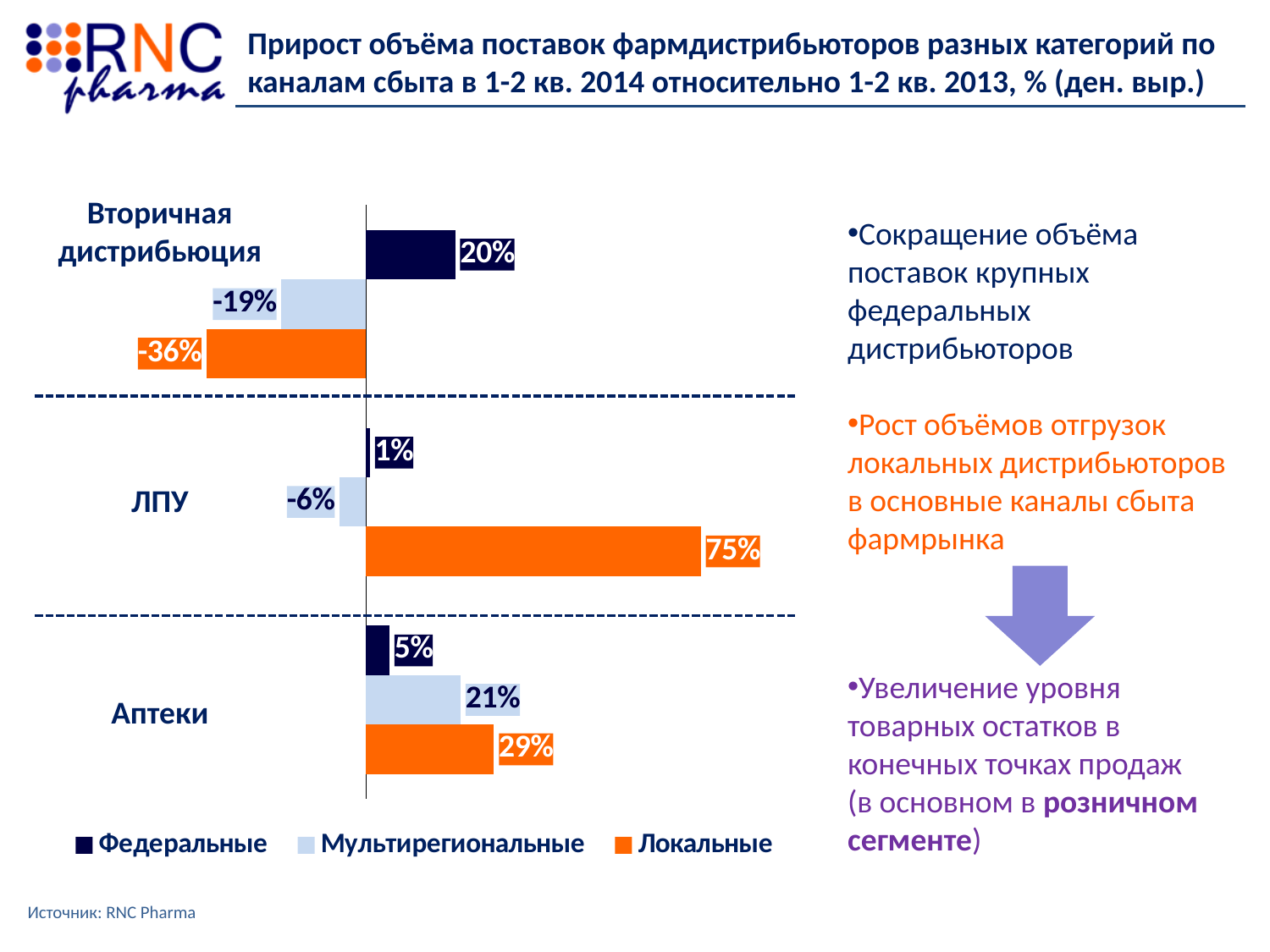
What is the value for Локальные in the ЛПУ category? 75% Which is larger in the Аптеки category: the Федеральные value or the Мультирегиональные value? Мультирегиональные Which series has the lowest value in the Вторичная дистрибьюция category? Локальные How many series does the legend list? 3 What is the value for Локальные in the Вторичная дистрибьюция category? -36% What is the difference between the Локальные and Мультирегиональные values in the Аптеки category? 8% What is the value for Федеральные in the Аптеки category? 5% Which colour represents the Локальные series in the chart? Orange Which series has the highest value in the ЛПУ category? Локальные How many categories are shown on the chart? 3 What kind of chart is shown on the slide? Bar chart What is the value for Мультирегиональные in the Вторичная дистрибьюция category? -19%